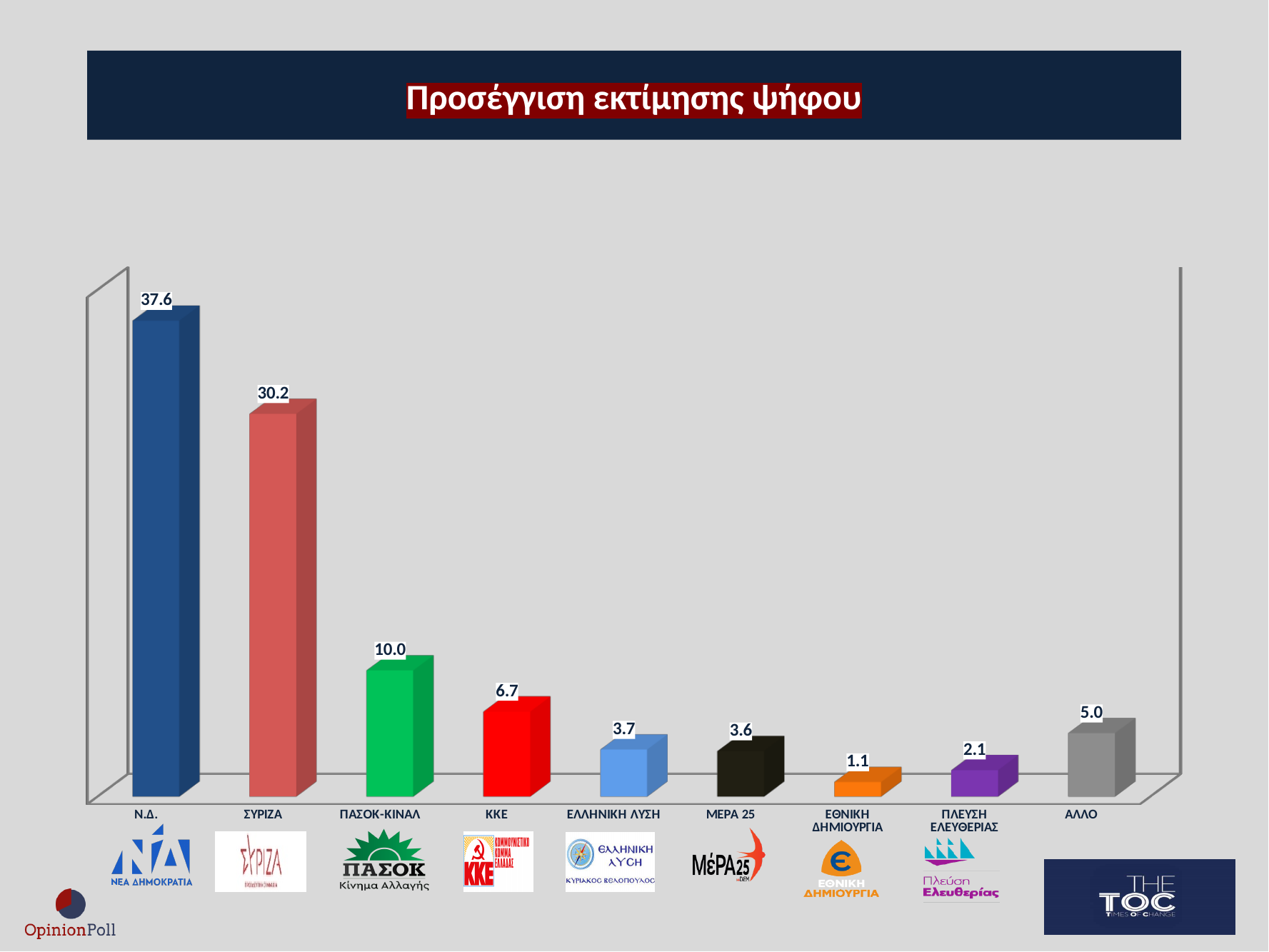
What kind of chart is shown on the slide? Bar chart Which is larger, the value for ΚΚΕ or the value for ΑΛΛΟ? ΚΚΕ What is the title of the chart? Προσέγγιση εκτίμησης ψήφου Which category has the highest value? Ν.Δ. What colour is the bar for ΠΛΕΥΣΗ ΕΛΕΥΘΕΡΙΑΣ? Purple How many categories are shown in the chart? 9 What is the value for ΕΘΝΙΚΗ ΔΗΜΙΟΥΡΓΙΑ? 1.1 What is the value for ΠΑΣΟΚ-ΚΙΝΑΛ? 10.0 What is the value for Ν.Δ.? 37.6 What is the difference between the values for Ν.Δ. and ΣΥΡΙΖΑ? 7.4 What is the value for ΣΥΡΙΖΑ? 30.2 Which category has the lowest value? ΕΘΝΙΚΗ ΔΗΜΙΟΥΡΓΙΑ